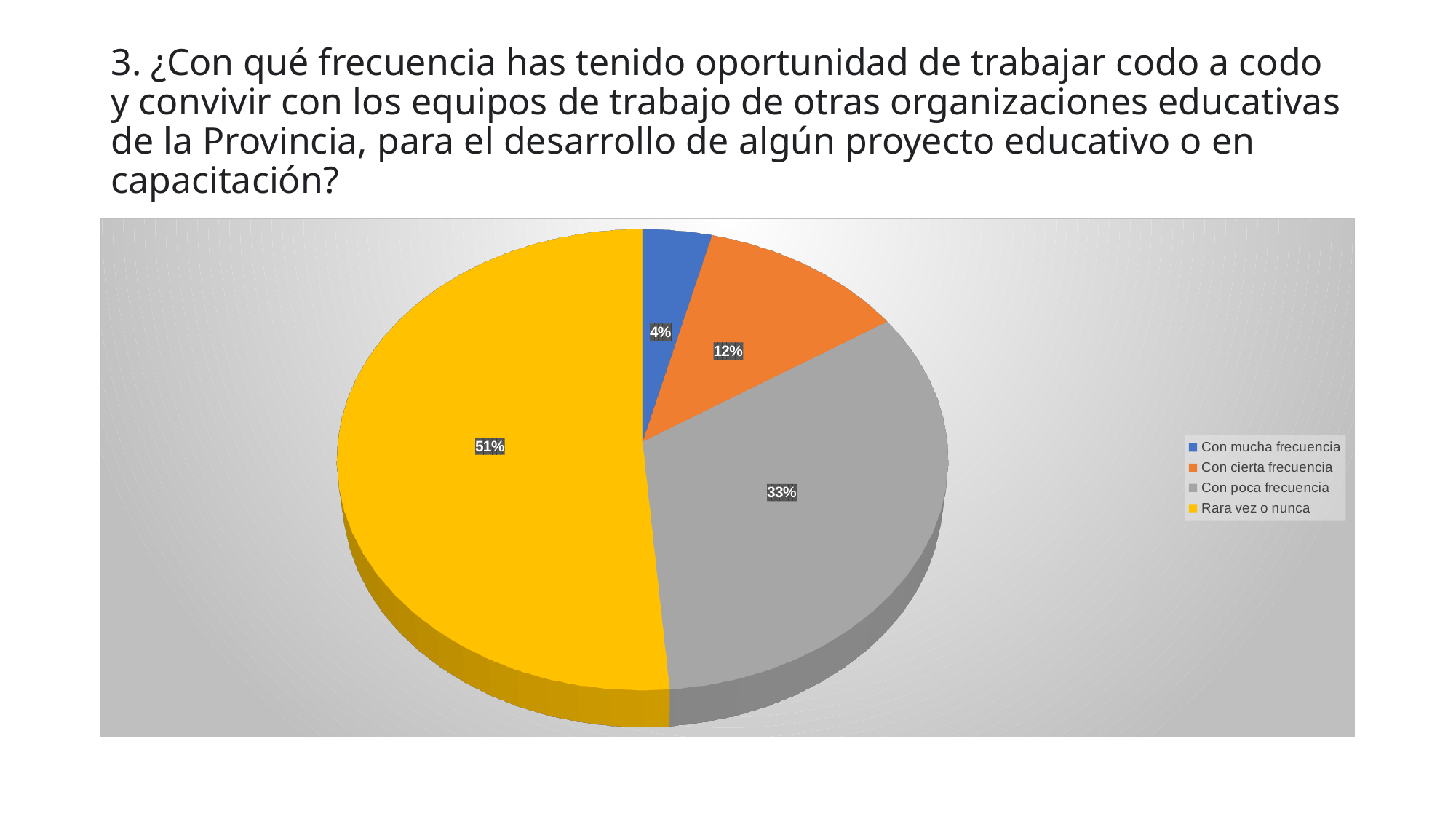
What colour is the 'Rara vez o nunca' slice? Yellow Which category has the smallest share of the pie? Con mucha frecuencia What is the combined share of 'Con mucha frecuencia' and 'Con cierta frecuencia'? 16% What percentage of responses is 'Con cierta frecuencia'? 12% What percentage of responses is 'Con mucha frecuencia'? 4% What percentage of responses is 'Con poca frecuencia'? 33% What is the difference in percentage points between 'Rara vez o nunca' and 'Con poca frecuencia'? 18 How many categories does the pie chart have? 4 Which category has the largest share of the pie? Rara vez o nunca What kind of chart is shown on the slide? Pie chart Which is larger: 'Con cierta frecuencia' or 'Con mucha frecuencia'? Con cierta frecuencia What percentage of responses is 'Rara vez o nunca'? 51%